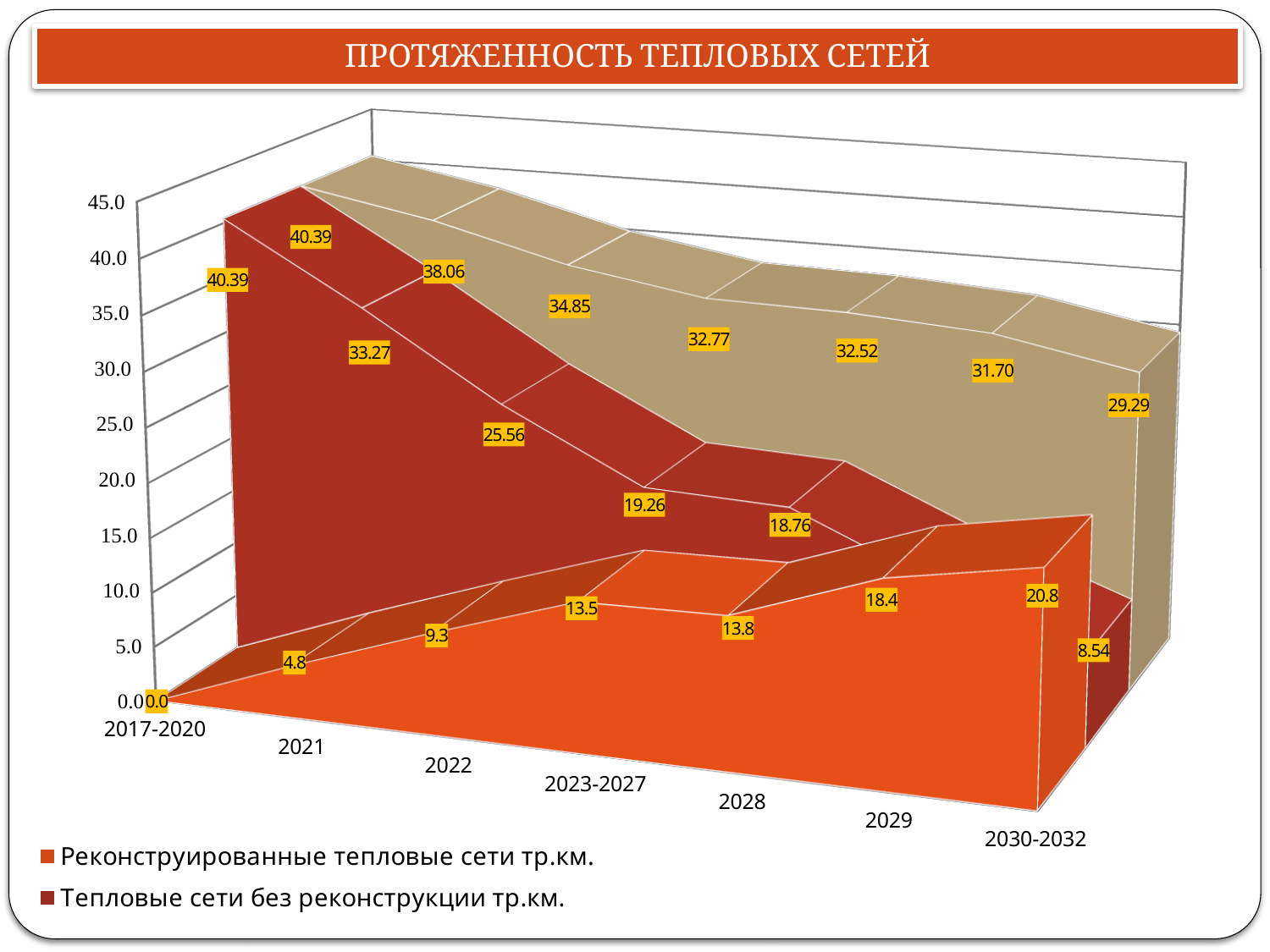
In which period is 'Тепловые сети без реконструкции тр.км.' lowest? 2030-2032 What is the difference between the 'Реконструированные тепловые сети тр.км.' values for 2029 and 2028? 4.6 How many periods are shown along the x axis of the chart? 7 For 2023-2027, which is larger: 'Тепловые сети без реконструкции тр.км.' or 'Реконструированные тепловые сети тр.км.'? Тепловые сети без реконструкции тр.км. What is the value of 'Тепловые сети без реконструкции тр.км.' for 2021? 33.27 What is the value of 'Реконструированные тепловые сети тр.км.' for 2030-2032? 20.8 What is the value of 'Тепловые сети без реконструкции тр.км.' for 2017-2020? 40.39 Do the values of 'Реконструированные тепловые сети тр.км.' rise or fall from 2017-2020 to 2030-2032? Rise What kind of chart is shown on the slide? Area chart In which period is 'Реконструированные тепловые сети тр.км.' highest? 2030-2032 What is the value of 'Реконструированные тепловые сети тр.км.' for 2022? 9.3 How many series does the chart legend list? 2